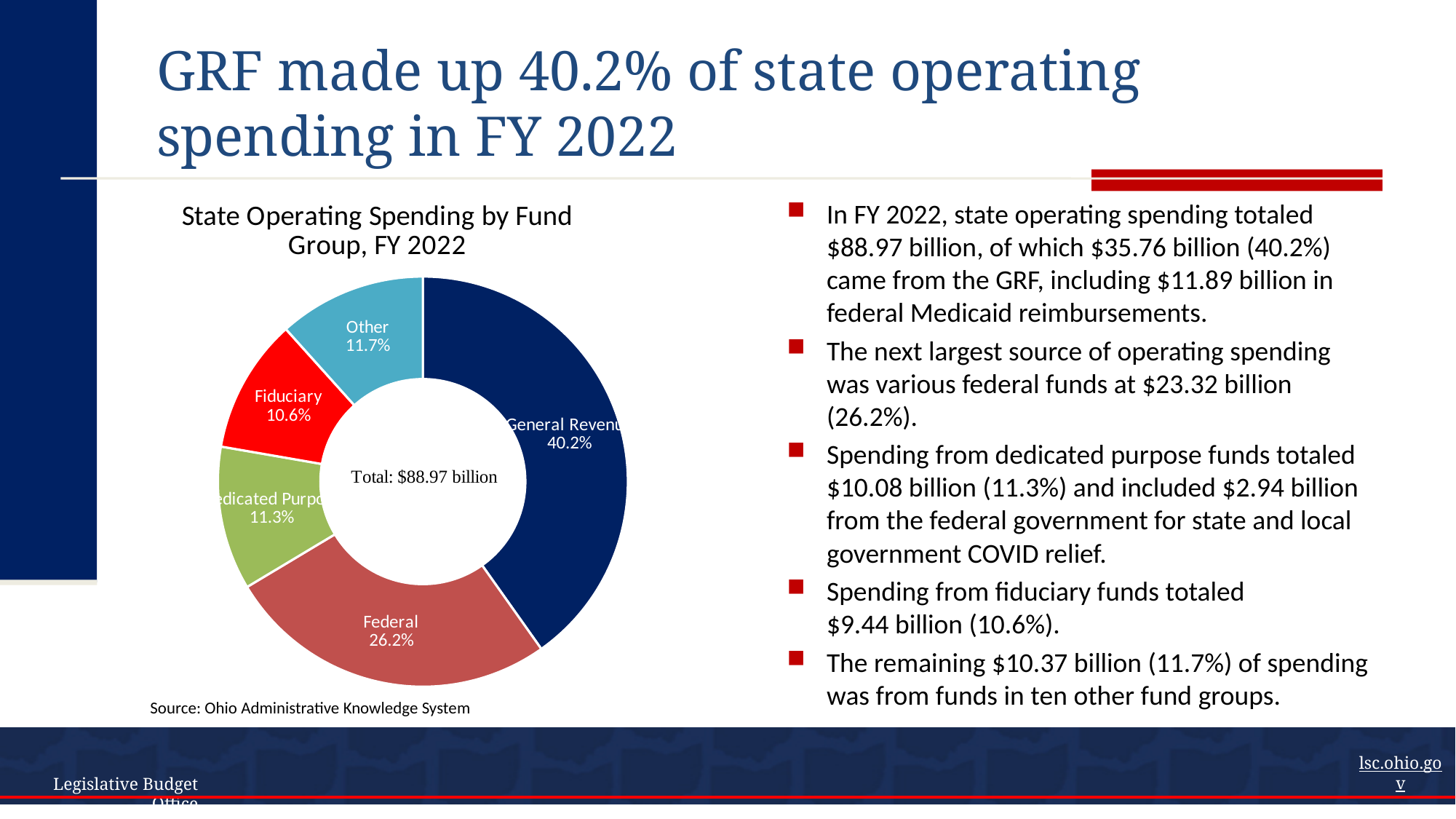
What share of state operating spending came from General Revenue? 40.2% Which fund group has the smallest share of the chart? Fiduciary What percentage is shown for Fiduciary? 10.6% What kind of chart is shown on the slide? Pie chart (donut) What total is printed in the centre of the chart? Total: $88.97 billion What percentage is shown for the Other slice? 11.7% How many slices does the chart have? 5 What percentage of the chart is labelled Federal? 26.2% What is the title of the chart? State Operating Spending by Fund Group, FY 2022 Which fund group has the largest share of the chart? General Revenue What is the difference in percentage points between General Revenue and Federal? 14.0 percentage points What percentage is shown for Dedicated Purpose? 11.3%